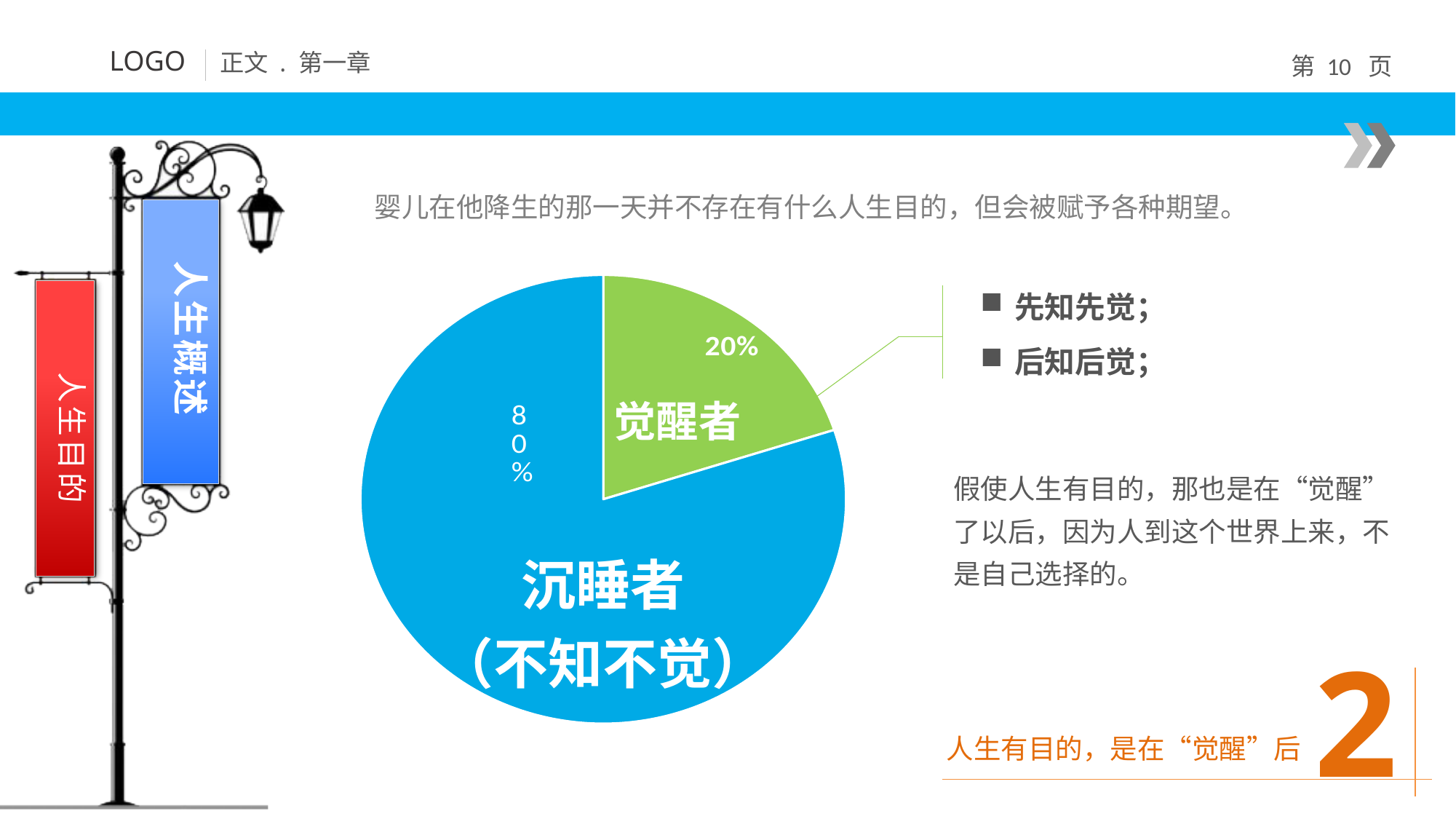
What is the difference in percentage points between the 沉睡者 slice and the 觉醒者 slice? 60 What colour is the 觉醒者 slice? green What percentage of the pie is labelled 沉睡者（不知不觉）? 80% Which slice is larger, 觉醒者 or 沉睡者（不知不觉）? 沉睡者（不知不觉） What percentage of the pie is labelled 觉醒者? 20% Which slice of the pie is the largest? 沉睡者（不知不觉） Which slice of the pie is the smallest? 觉醒者 What share of the pie does the 觉醒者 slice represent? 20% How many slices does the pie chart have? 2 What colour is the 沉睡者（不知不觉） slice? blue What kind of chart is shown on the slide? pie chart